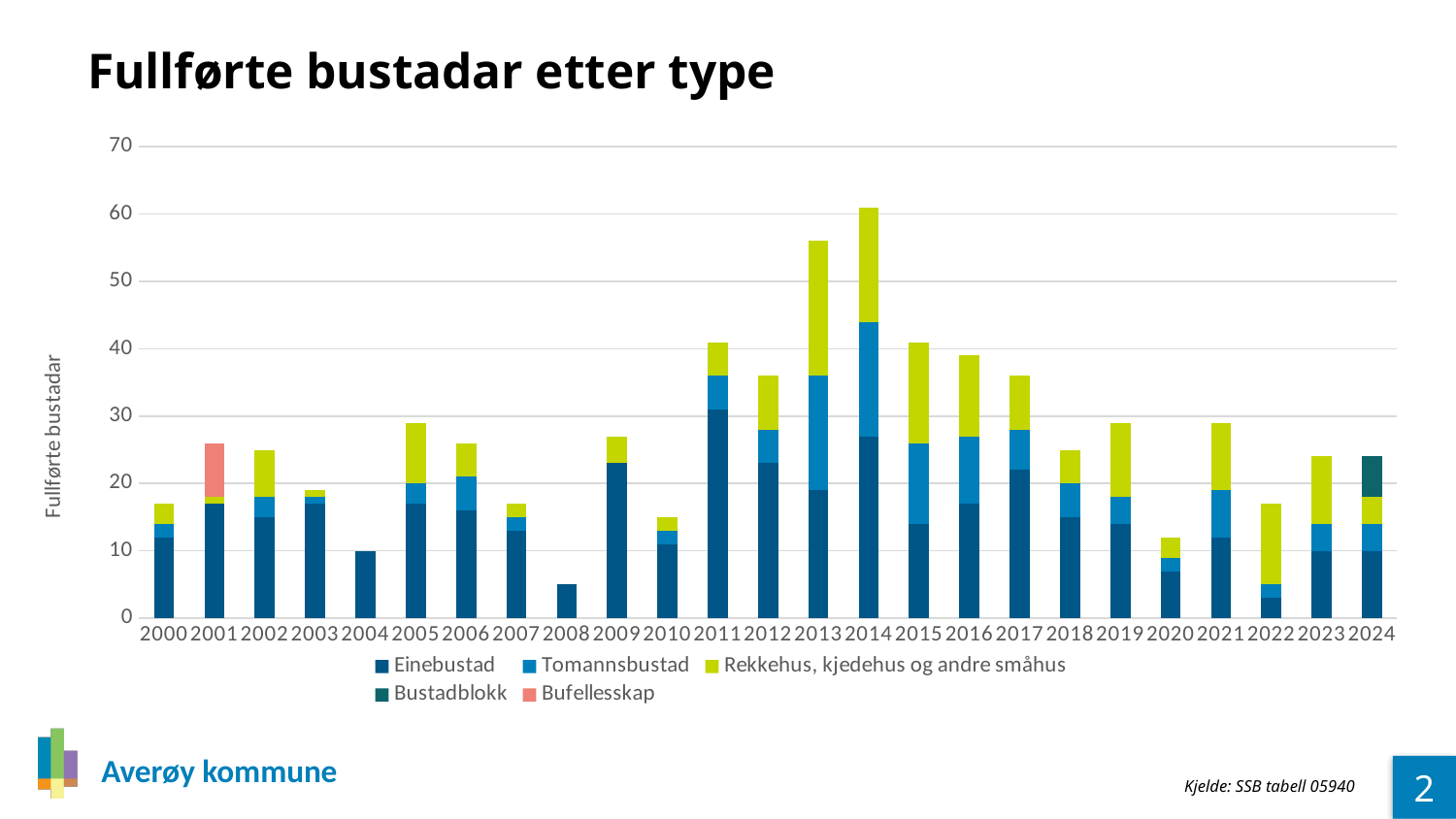
Is the total for 2014 greater or less than 50? greater How many series does the legend list? 5 Which year has the lowest total of completed dwellings? 2008 Is the total for 2011 greater or less than 30? greater In which year does the Bufellesskap series appear? 2001 Which year has the highest total of completed dwellings? 2014 Which year has the larger total, 2013 or 2015? 2013 What kind of chart is shown on the slide? bar chart How many years are shown on the x axis? 25 Is the total for 2020 greater or less than 20? less Which year has the larger total, 2009 or 2010? 2009